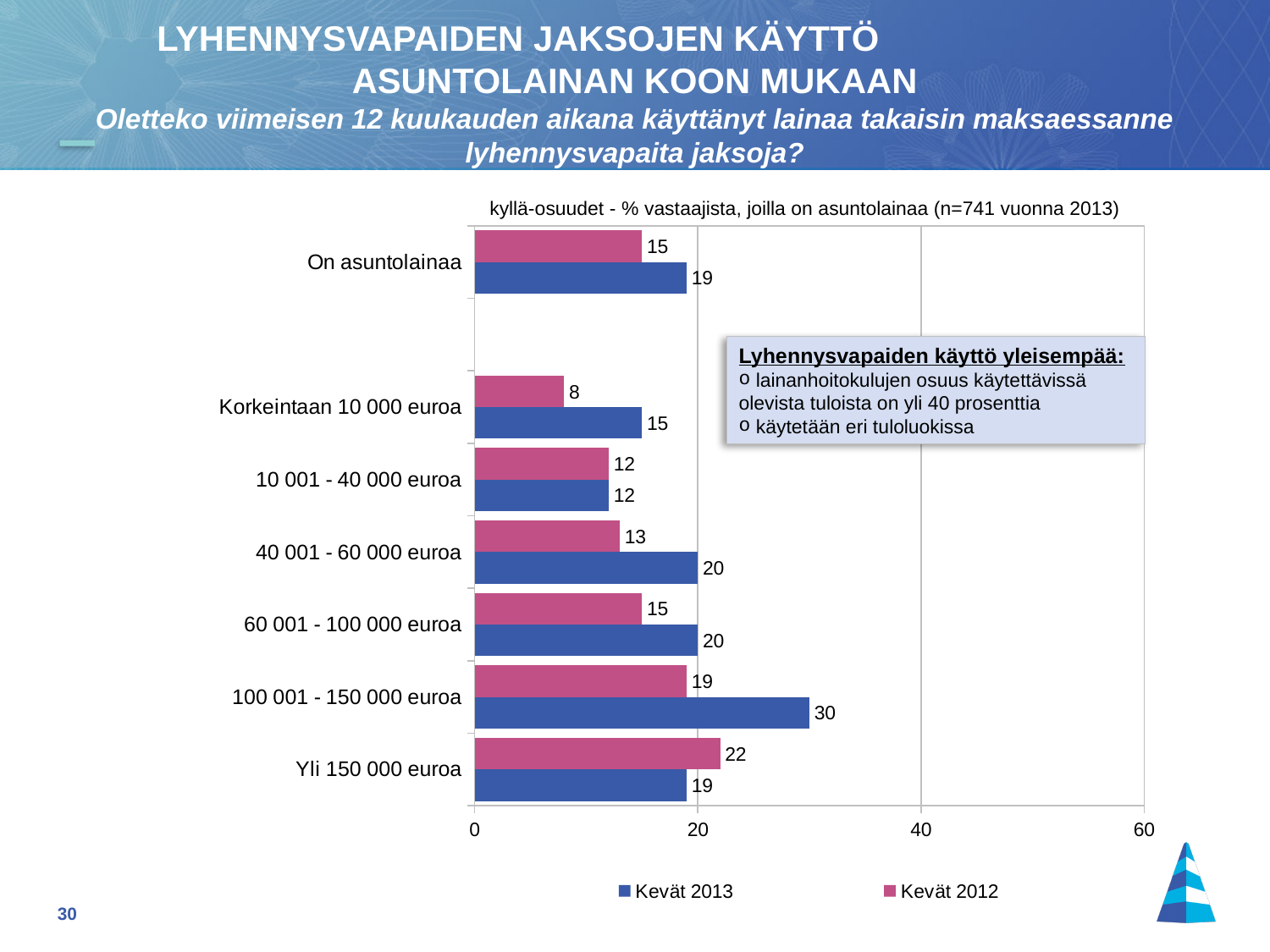
Is the Kevät 2013 value for 40 001 - 60 000 euroa greater or less than 40? less What is the Kevät 2013 value for On asuntolainaa? 19 Which colour represents the Kevät 2012 series in the legend? Pink Which category has the highest Kevät 2013 value? 100 001 - 150 000 euroa What is the difference between the Kevät 2013 and Kevät 2012 values for 100 001 - 150 000 euroa? 11 What kind of chart is shown on the slide? Bar chart How many categories are shown on the chart? 7 What is the Kevät 2012 value for Korkeintaan 10 000 euroa? 8 What is the Kevät 2013 value for 100 001 - 150 000 euroa? 30 Which category has the lowest Kevät 2012 value? Korkeintaan 10 000 euroa How many series does the legend list? 2 For Yli 150 000 euroa, which series has the larger value, Kevät 2013 or Kevät 2012? Kevät 2012